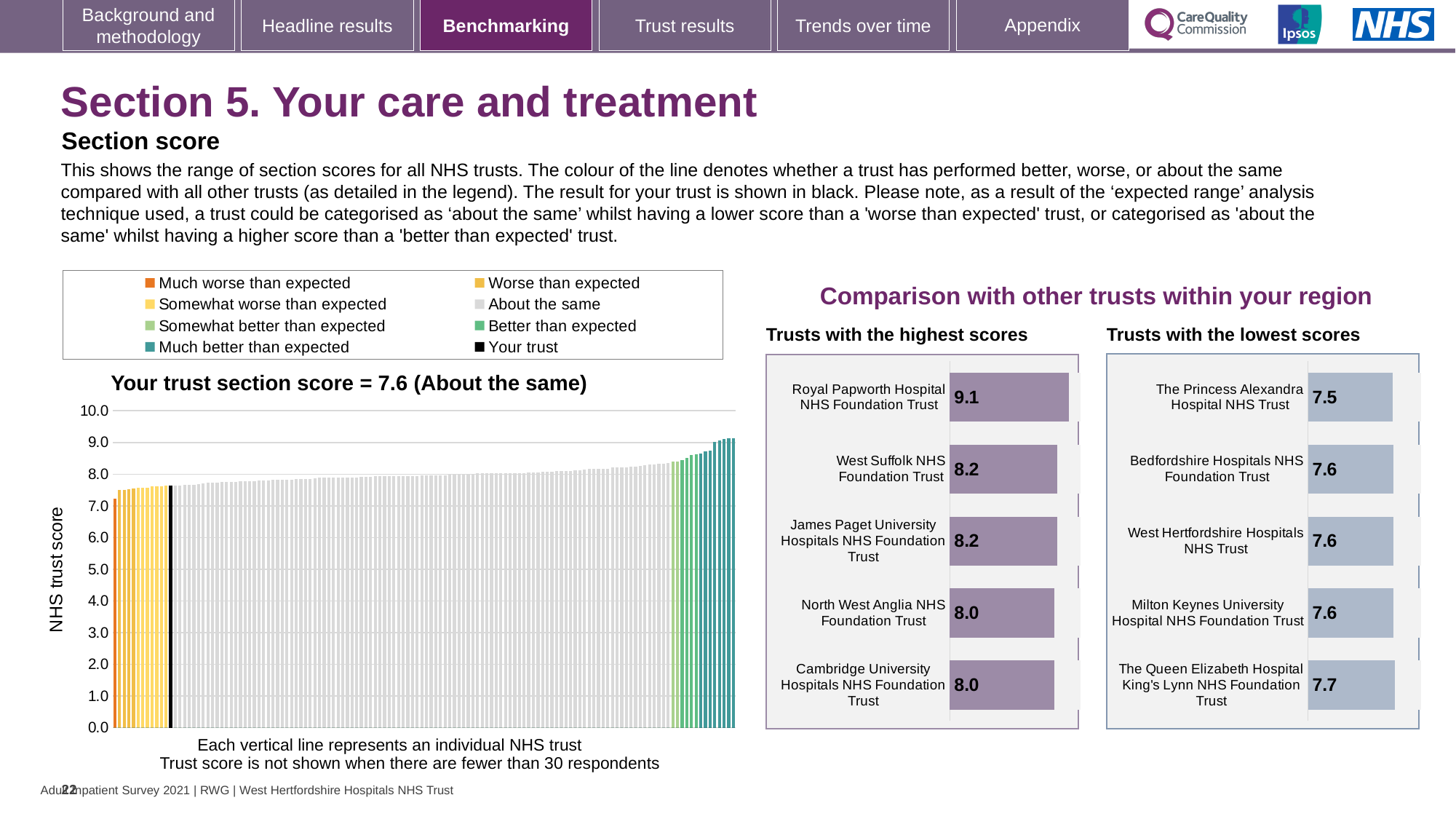
In the 'Your trust section score' chart, how many entries does the legend list? 8 In the 'Trusts with the highest scores' chart, what is the difference between the scores of Royal Papworth Hospital NHS Foundation Trust and Cambridge University Hospitals NHS Foundation Trust? 1.1 In the 'Trusts with the lowest scores' chart, which trust has the lowest score? The Princess Alexandra Hospital NHS Trust In the 'Trusts with the highest scores' chart, what is the score for Royal Papworth Hospital NHS Foundation Trust? 9.1 In the 'Your trust section score' chart, do the trust scores rise or fall from left to right along the x axis? rise In the 'Your trust section score' chart, what is the section score for your trust? 7.6 In the 'Trusts with the lowest scores' chart, how many trusts are listed? 5 In the 'Your trust section score' chart, what is the label on the vertical axis? NHS trust score In the 'Your trust section score' chart, is the value for the black 'Your trust' bar greater or less than 8.0? less In the 'Trusts with the lowest scores' chart, which has the larger score: The Queen Elizabeth Hospital King's Lynn NHS Foundation Trust or The Princess Alexandra Hospital NHS Trust? The Queen Elizabeth Hospital King's Lynn NHS Foundation Trust In the 'Your trust section score' chart, what kind of chart is shown? bar chart In the 'Trusts with the highest scores' chart, which trust has the highest score? Royal Papworth Hospital NHS Foundation Trust